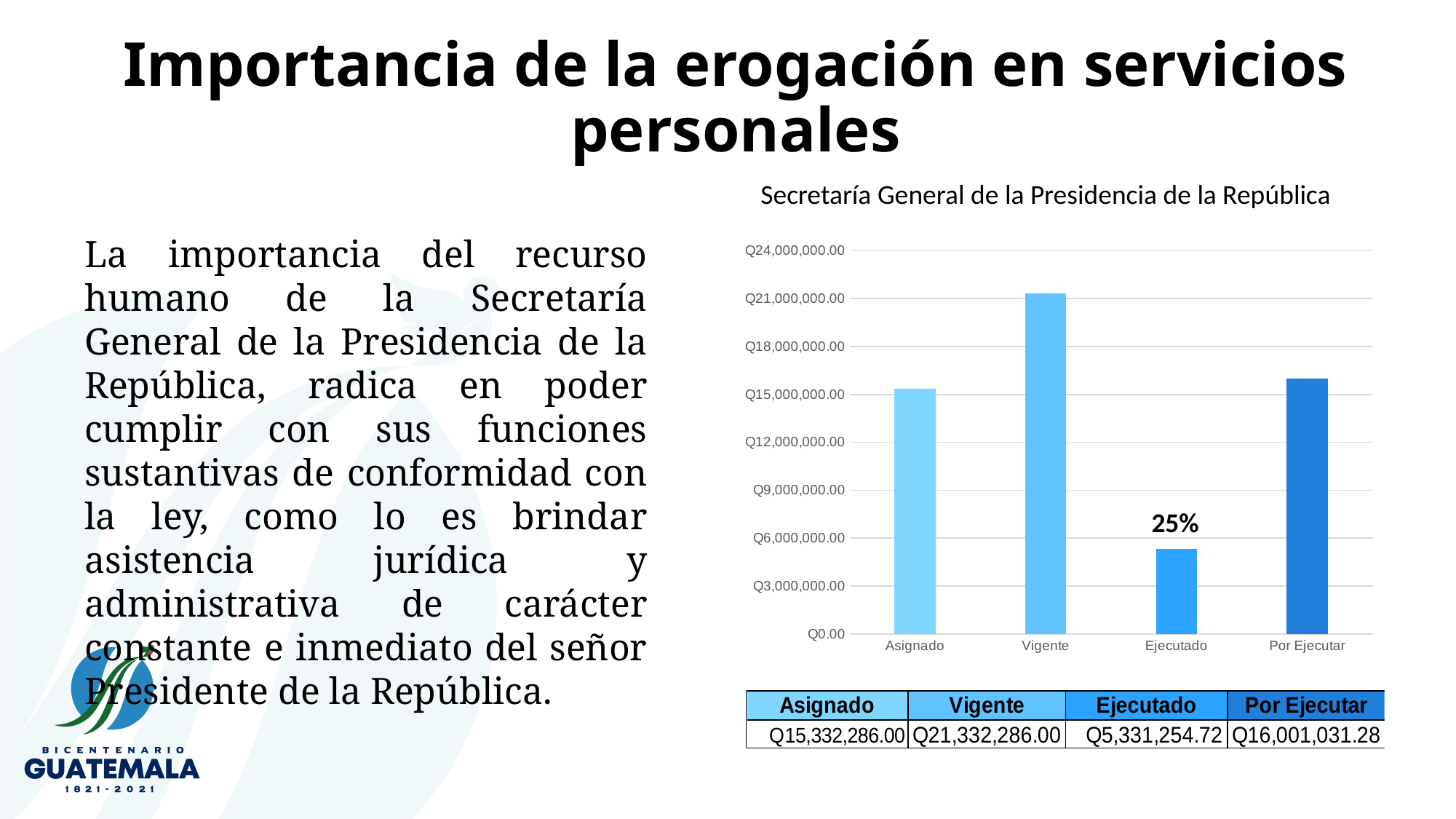
What percentage label is shown above the Ejecutado bar? 25% What is the value for Vigente? Q21,332,286.00 What is the difference between Vigente and Ejecutado? Q16,001,031.28 Which is larger, Por Ejecutar or Asignado? Por Ejecutar What is the value for Ejecutado? Q5,331,254.72 What kind of chart is shown? Bar chart How many categories are shown on the chart? 4 What is the difference between Vigente and Asignado? Q6,000,000.00 What is the value for Asignado? Q15,332,286.00 What is the value for Por Ejecutar? Q16,001,031.28 Which category has the lowest value? Ejecutado Which category has the highest value? Vigente